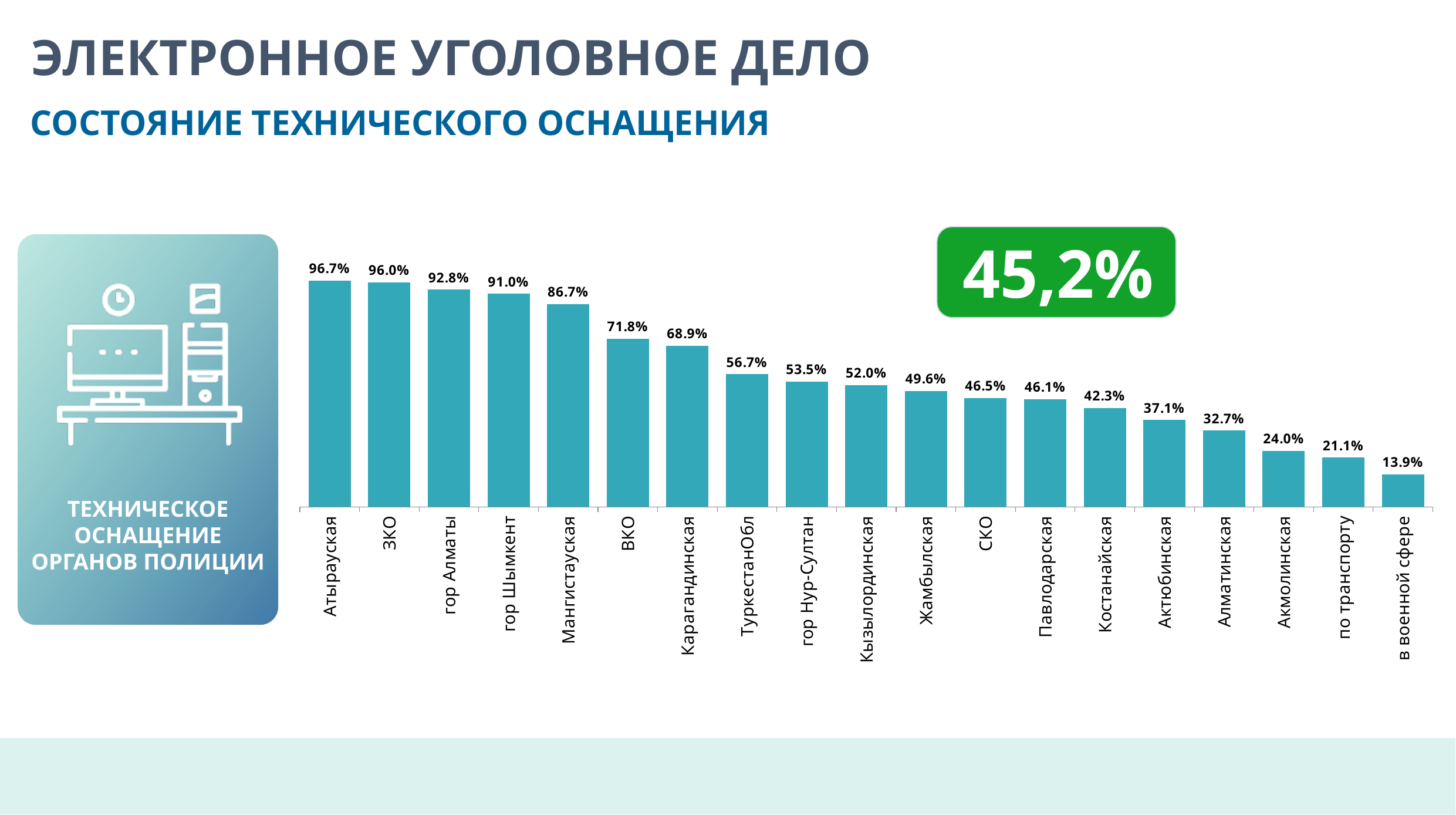
Which is larger, the value for Мангистауская or the value for ВКО? Мангистауская How many categories are shown in the chart? 19 What is the difference between the values for ВКО and Карагандинская? 2.9% What kind of chart is shown on the slide? Bar chart Do the values rise or fall from left to right along the x axis? Fall What is the value for Атырауская? 96.7% What is the value for Карагандинская? 68.9% Which category has the lowest value? в военной сфере What is the difference between the values for гор Алматы and гор Шымкент? 1.8% Which category has the highest value? Атырауская What is the value for гор Нур-Султан? 53.5% What is the value for Акмолинская? 24.0%